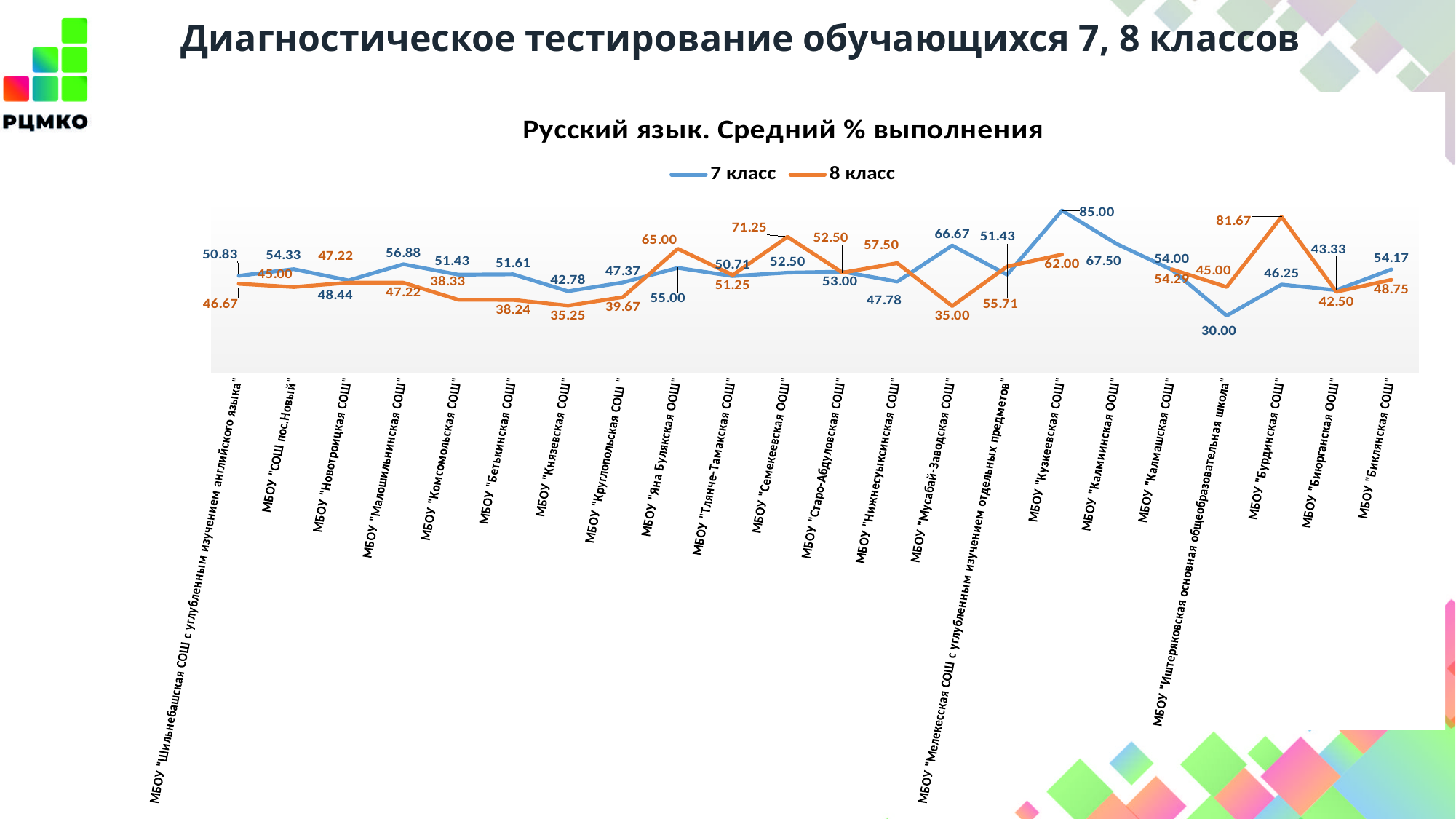
What is the 8 класс value for МБОУ "Бурдинская СОШ"? 81.67 Which school has the highest 7 класс value? МБОУ "Кузкеевская СОШ" What is the 8 класс value for МБОУ "Семекеевская ООШ"? 71.25 What type of chart is shown on the slide? Line chart How many series does the legend list? 2 What is the 7 класс value for МБОУ "Иштеряковская основная общеобразовательная школа"? 30.00 What is the 7 класс value for МБОУ "Кузкеевская СОШ"? 85.00 For МБОУ "Мусабай-Заводская СОШ", which is larger: the 7 класс value or the 8 класс value? 7 класс Which school has the highest 8 класс value? МБОУ "Бурдинская СОШ" What is the title of the chart? Русский язык. Средний % выполнения What is the difference between the 7 класс and 8 класс values for МБОУ "Кузкеевская СОШ"? 23.00 Which school has the lowest 7 класс value? МБОУ "Иштеряковская основная общеобразовательная школа"